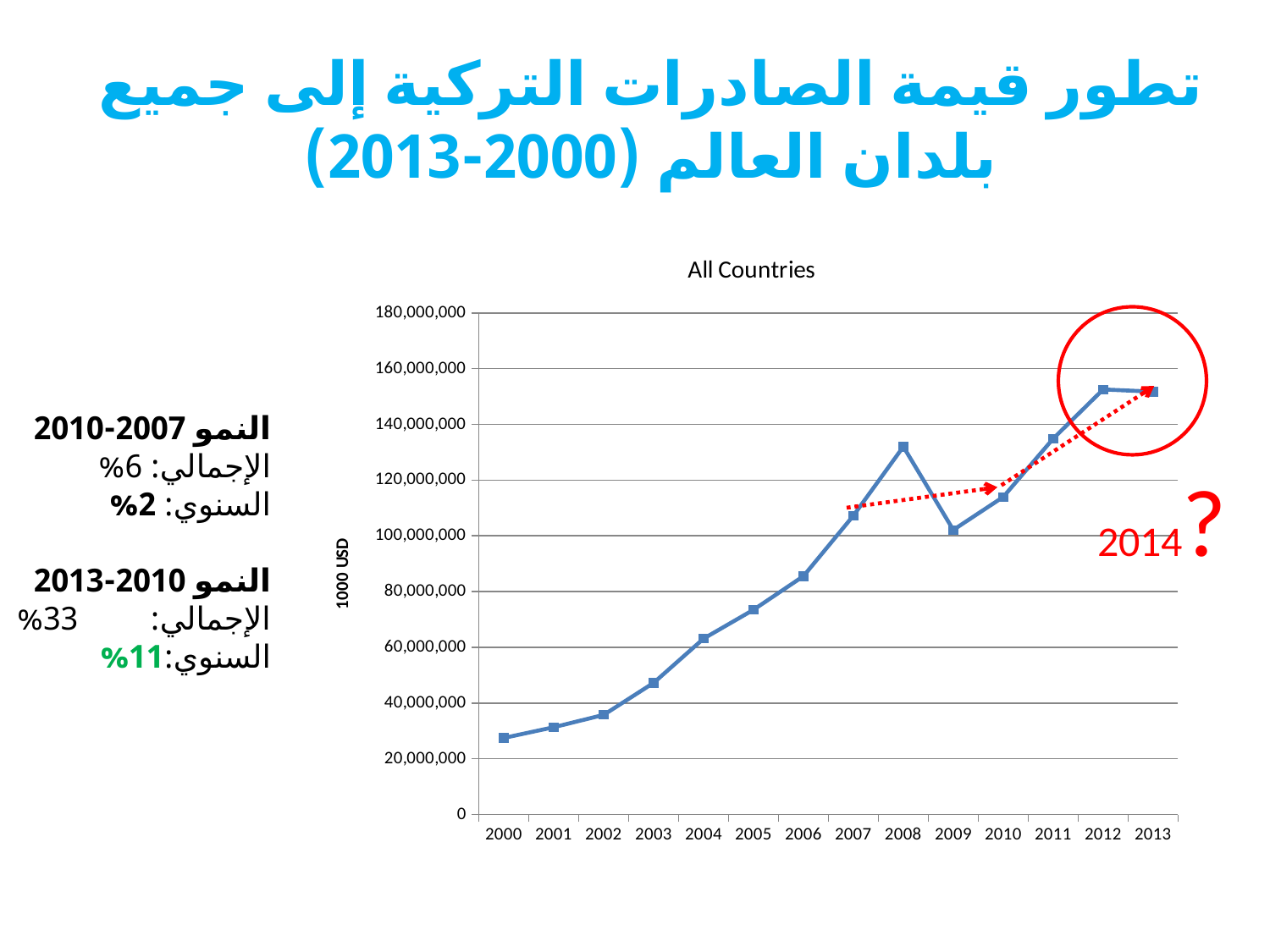
What is the label on the vertical axis of the chart? 1000 USD Which year has the lowest value on the chart? 2000 Is the value for 2009 greater or less than 120,000,000? less Is the value for 2008 greater or less than 120,000,000? greater Which year has the larger value, 2008 or 2009? 2008 How many years are plotted on the x axis of the chart? 14 What is the title of the chart? All Countries Is the value for 2003 greater or less than 60,000,000? less Do the values generally rise or fall from 2000 to 2013? rise What kind of chart is shown on the slide? line chart